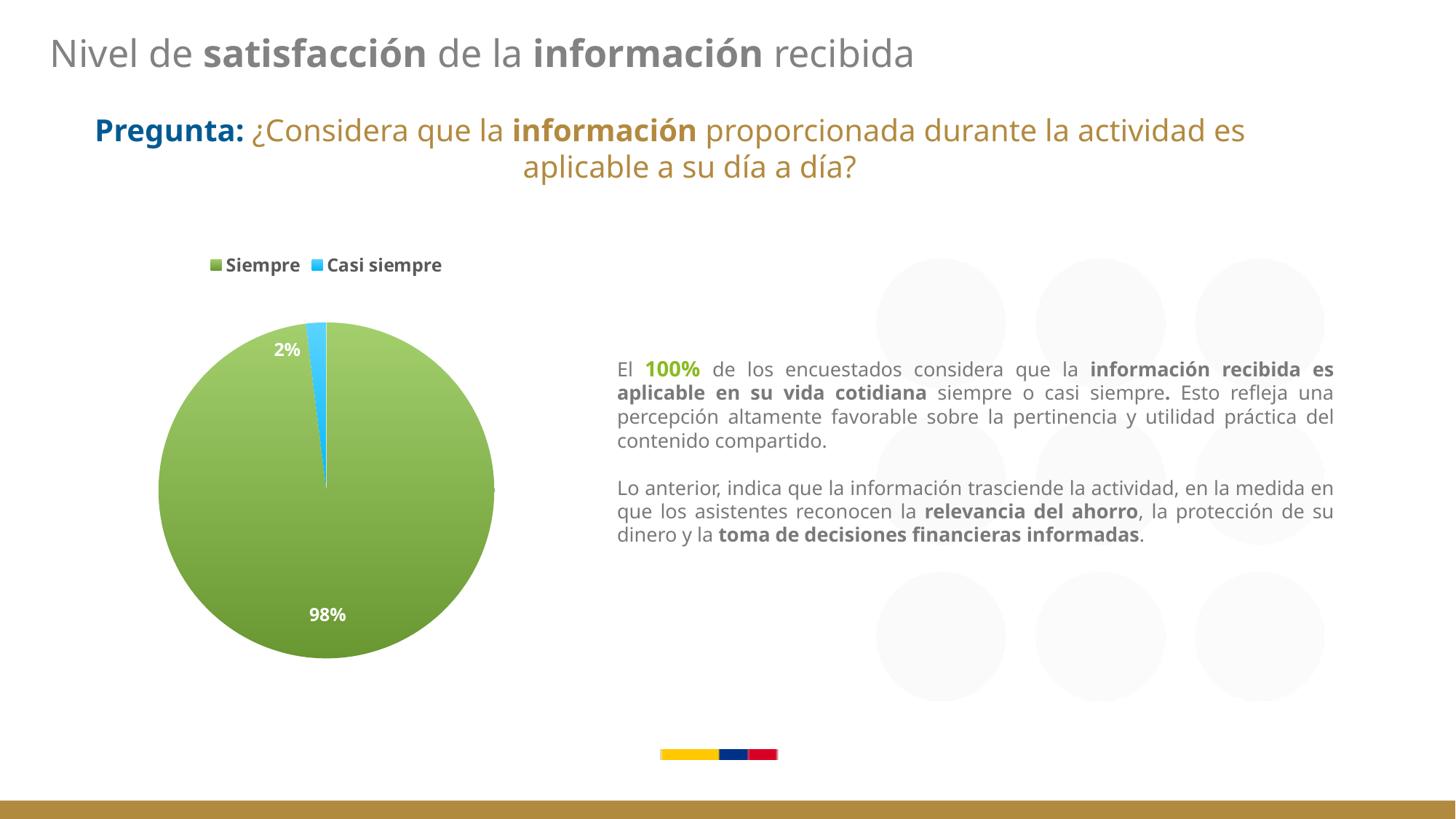
What colour is the "Siempre" slice in the pie chart? Green What kind of chart is shown on the slide? Pie chart How many slices does the pie chart have? 2 What percentage of the pie chart corresponds to "Siempre"? 98% What is the difference in percentage points between the "Siempre" and "Casi siempre" slices? 96 What colour is the "Casi siempre" slice in the pie chart? Blue How many entries does the chart legend list? 2 Which slice is larger, "Siempre" or "Casi siempre"? Siempre Which category has the smallest slice in the pie chart? Casi siempre What percentage of the pie chart corresponds to "Casi siempre"? 2% Which category has the largest slice in the pie chart? Siempre What is the combined share of the "Siempre" and "Casi siempre" slices? 100%